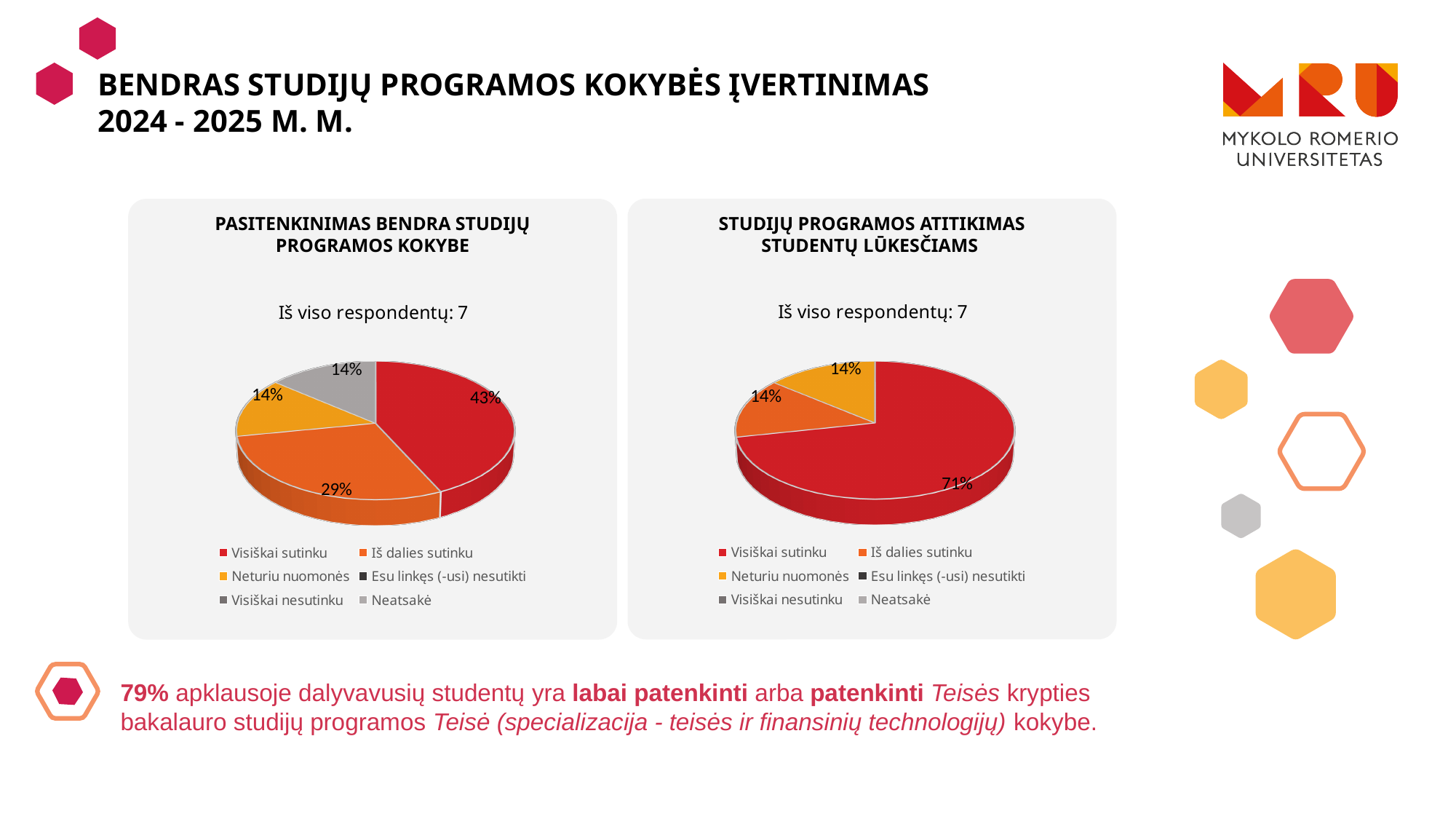
In the 'Pasitenkinimas bendra studijų programos kokybe' chart, what share is labelled for 'Visiškai sutinku'? 43% How many slices are shown in the 'Pasitenkinimas bendra studijų programos kokybe' pie chart? 4 In the 'Pasitenkinimas bendra studijų programos kokybe' chart, which category has the largest slice? Visiškai sutinku In the 'Studijų programos atitikimas studentų lūkesčiams' chart, which category has the largest slice? Visiškai sutinku In the 'Studijų programos atitikimas studentų lūkesčiams' chart, what share is labelled for 'Neturiu nuomonės'? 14% How many entries does the legend of the 'Studijų programos atitikimas studentų lūkesčiams' chart list? 6 How many slices are shown in the 'Studijų programos atitikimas studentų lūkesčiams' pie chart? 3 Which chart has the larger 'Visiškai sutinku' share: 'Pasitenkinimas bendra studijų programos kokybe' or 'Studijų programos atitikimas studentų lūkesčiams'? Studijų programos atitikimas studentų lūkesčiams In the 'Pasitenkinimas bendra studijų programos kokybe' chart, what share is labelled for 'Iš dalies sutinku'? 29% In the 'Studijų programos atitikimas studentų lūkesčiams' chart, what share is labelled for 'Visiškai sutinku'? 71% In the 'Pasitenkinimas bendra studijų programos kokybe' chart, what is the difference between the 'Visiškai sutinku' and 'Iš dalies sutinku' shares? 14% What kind of chart is used in the 'Pasitenkinimas bendra studijų programos kokybe' panel? pie chart